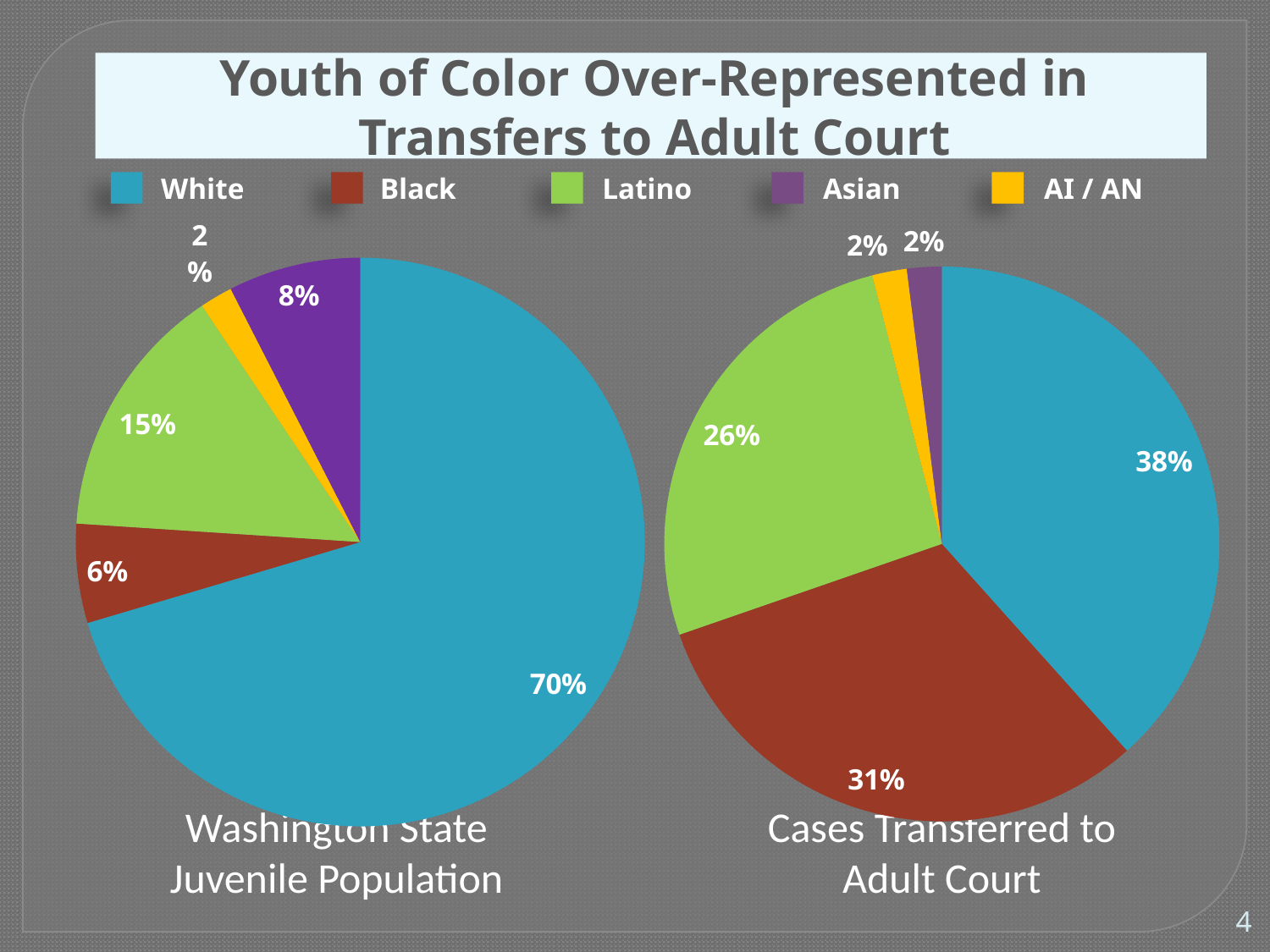
Is the Black share larger in the Washington State Juvenile Population chart or in the Cases Transferred to Adult Court chart? Cases Transferred to Adult Court In the Washington State Juvenile Population chart, what share is Latino? 15% What is the difference between the White share in the Washington State Juvenile Population chart and the White share in the Cases Transferred to Adult Court chart? 32% What colour represents Latino in the charts? Green In the Washington State Juvenile Population chart, which group has the smallest share? AI / AN In the Cases Transferred to Adult Court chart, what share is Black? 31% What type of chart is used for the Cases Transferred to Adult Court data? Pie chart In the Washington State Juvenile Population chart, what share is Asian? 8% In the Cases Transferred to Adult Court chart, what share is Latino? 26% How many groups does the legend list? 5 In the Washington State Juvenile Population chart, what share is White? 70% In the Cases Transferred to Adult Court chart, which group has the largest share? White